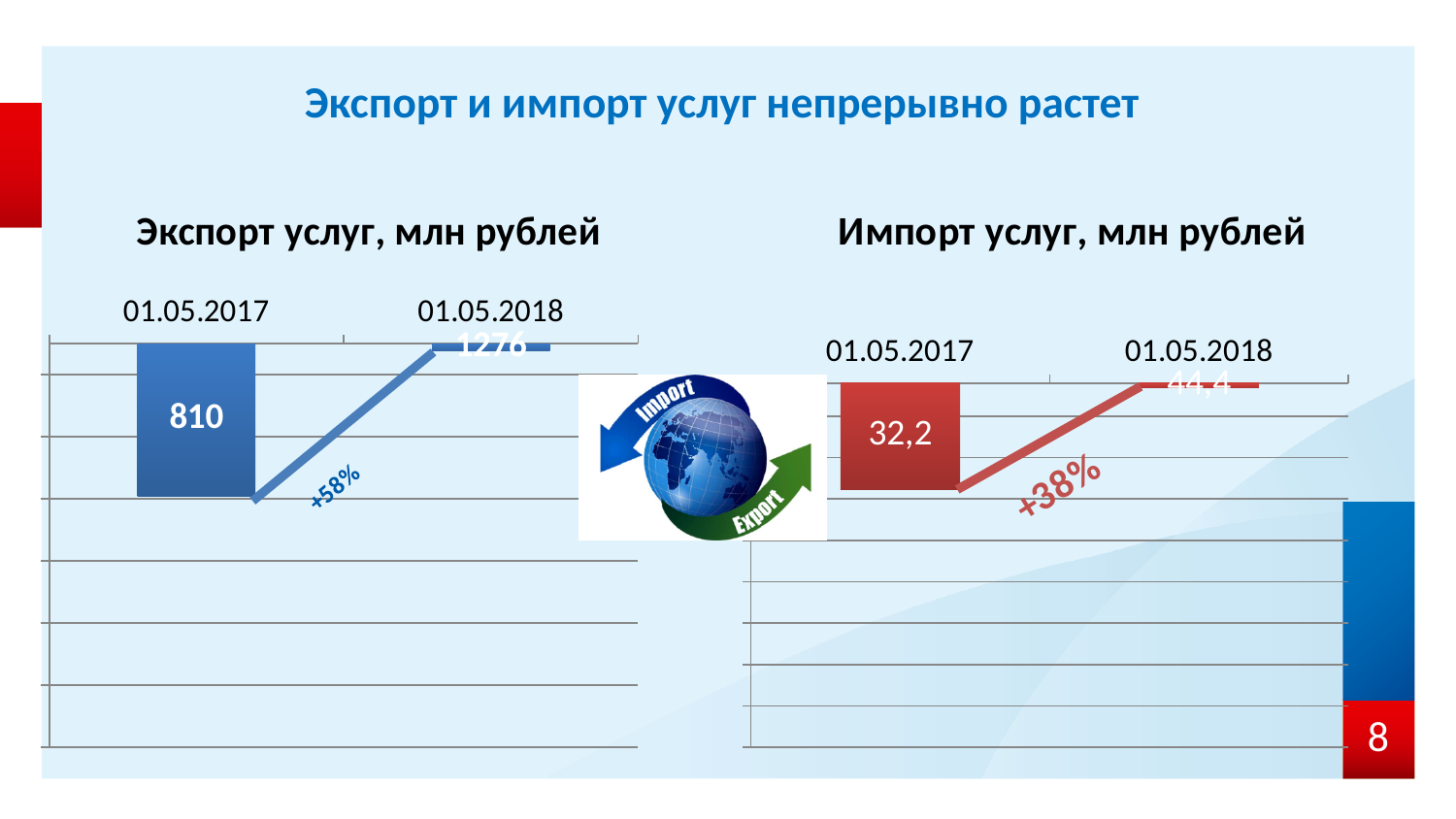
On the chart titled 'Экспорт услуг, млн рублей', what is the value for 01.05.2018? 1276 On the chart titled 'Экспорт услуг, млн рублей', which date has the higher value, 01.05.2017 or 01.05.2018? 01.05.2018 On the chart titled 'Экспорт услуг, млн рублей', what is the value for 01.05.2017? 810 On the chart titled 'Импорт услуг, млн рублей', what is the value for 01.05.2018? 44,4 How many dates are shown on the x axis of the chart titled 'Импорт услуг, млн рублей'? 2 On the chart titled 'Экспорт услуг, млн рублей', do the values rise or fall from 01.05.2017 to 01.05.2018? rise On the chart titled 'Импорт услуг, млн рублей', what is the difference between the 01.05.2018 and 01.05.2017 values? 12,2 On the chart titled 'Экспорт услуг, млн рублей', by how much did the value increase from 01.05.2017 to 01.05.2018? 466 On the chart titled 'Импорт услуг, млн рублей', which date has the lower value? 01.05.2017 On the chart titled 'Импорт услуг, млн рублей', what is the value for 01.05.2017? 32,2 What percentage growth is labelled on the chart titled 'Экспорт услуг, млн рублей'? +58% What percentage growth is labelled on the chart titled 'Импорт услуг, млн рублей'? +38%